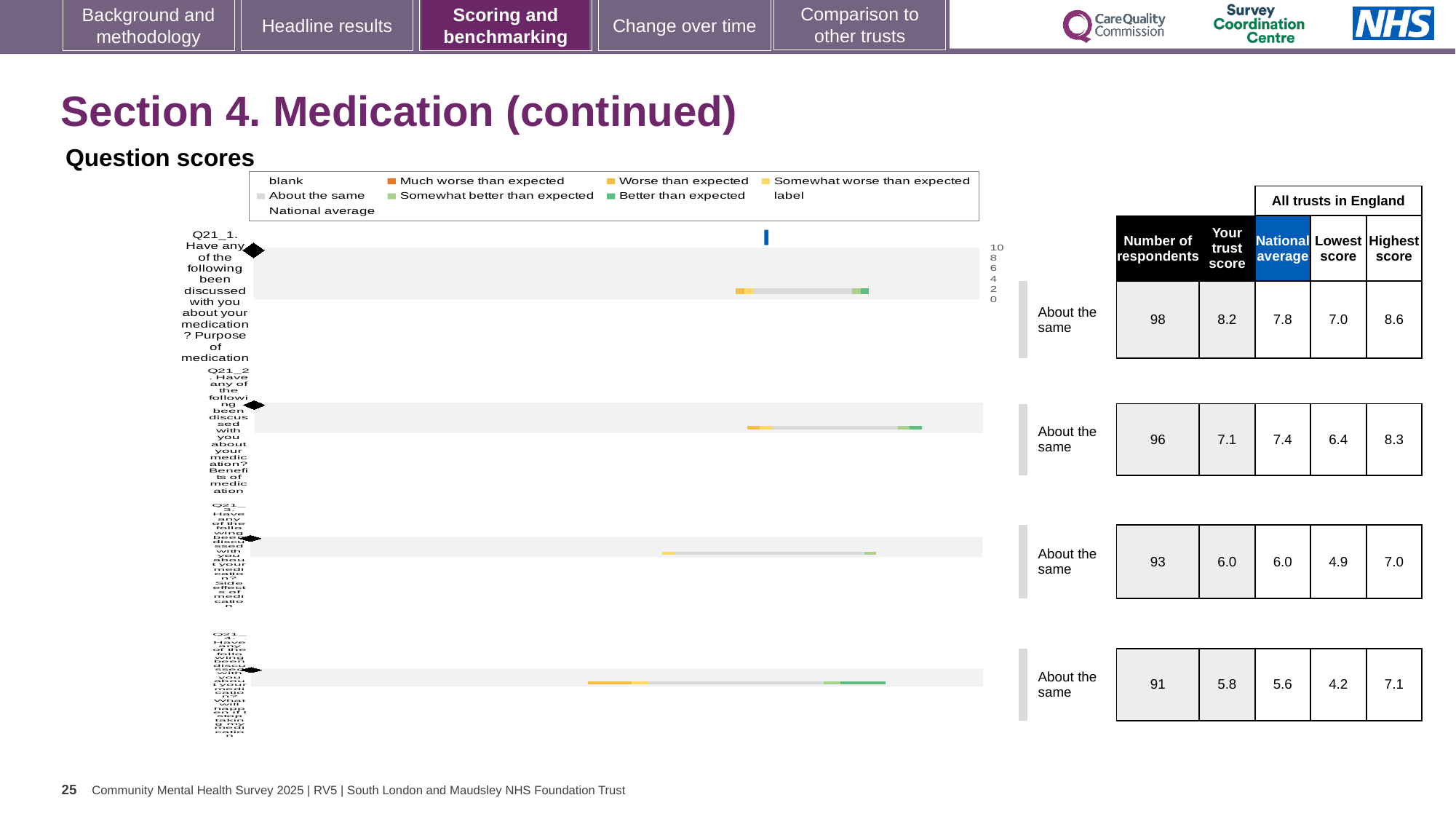
In the table beside the question scores chart, what is the national average for Q21_2 (Benefits of medication)? 7.4 For Q21_1, what is the difference between the trust score (8.2) and the national average (7.8)? 0.4 Which of the four questions has the highest 'Your trust score' in the table beside the chart? Q21_1 In the table beside the question scores chart, what is the highest score across all trusts in England for Q21_4? 7.1 Which benchmark category is shown for Q21_1 (Purpose of medication) in the question scores chart? About the same Which of the four questions has the lowest 'Your trust score' in the table beside the chart? Q21_4 In the table beside the question scores chart, how many respondents answered Q21_3 (Side effects of medication)? 93 What kind of chart is used to show the question scores on this slide? bar chart In the legend of the question scores chart, what colour represents 'Much worse than expected'? orange For Q21_1, which is larger: the trust score or the national average? the trust score How many questions (bars) are plotted in the question scores chart? 4 In the table beside the question scores chart, what is the 'Your trust score' for Q21_1 (Purpose of medication)? 8.2